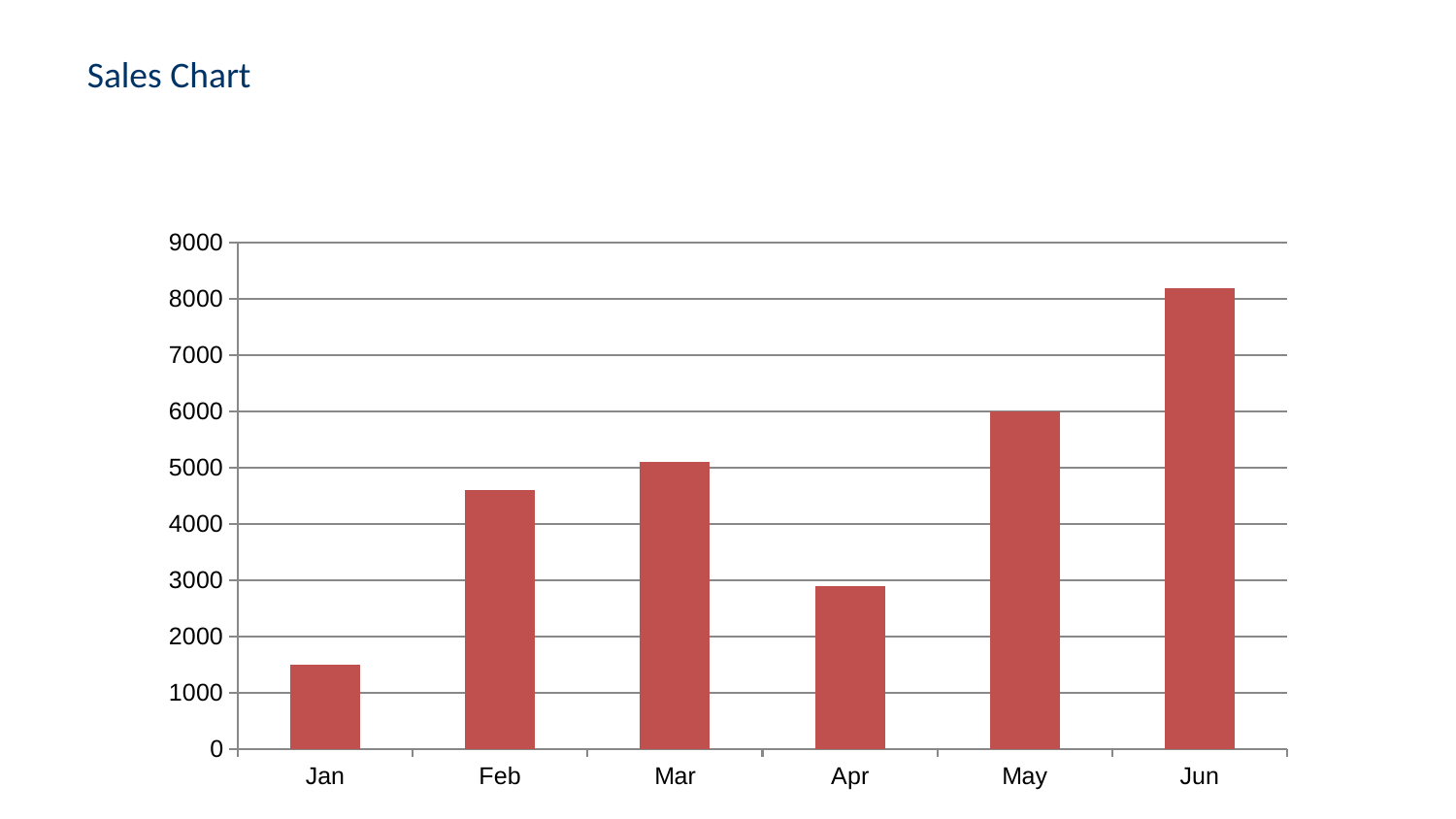
Which month has the lowest value? Jan What is the title of the slide? Sales Chart What is the value for May? 6000 Which month has the highest value? Jun Is the value for Apr greater or less than 2000? greater Is the value for Jan greater or less than 2000? less Which is larger, the value for Feb or the value for Mar? Mar Do the values rise or fall from Apr to Jun? rise Is the value for Feb greater or less than 4000? greater What kind of chart is shown on the slide? bar chart How many months are shown on the x axis? 6